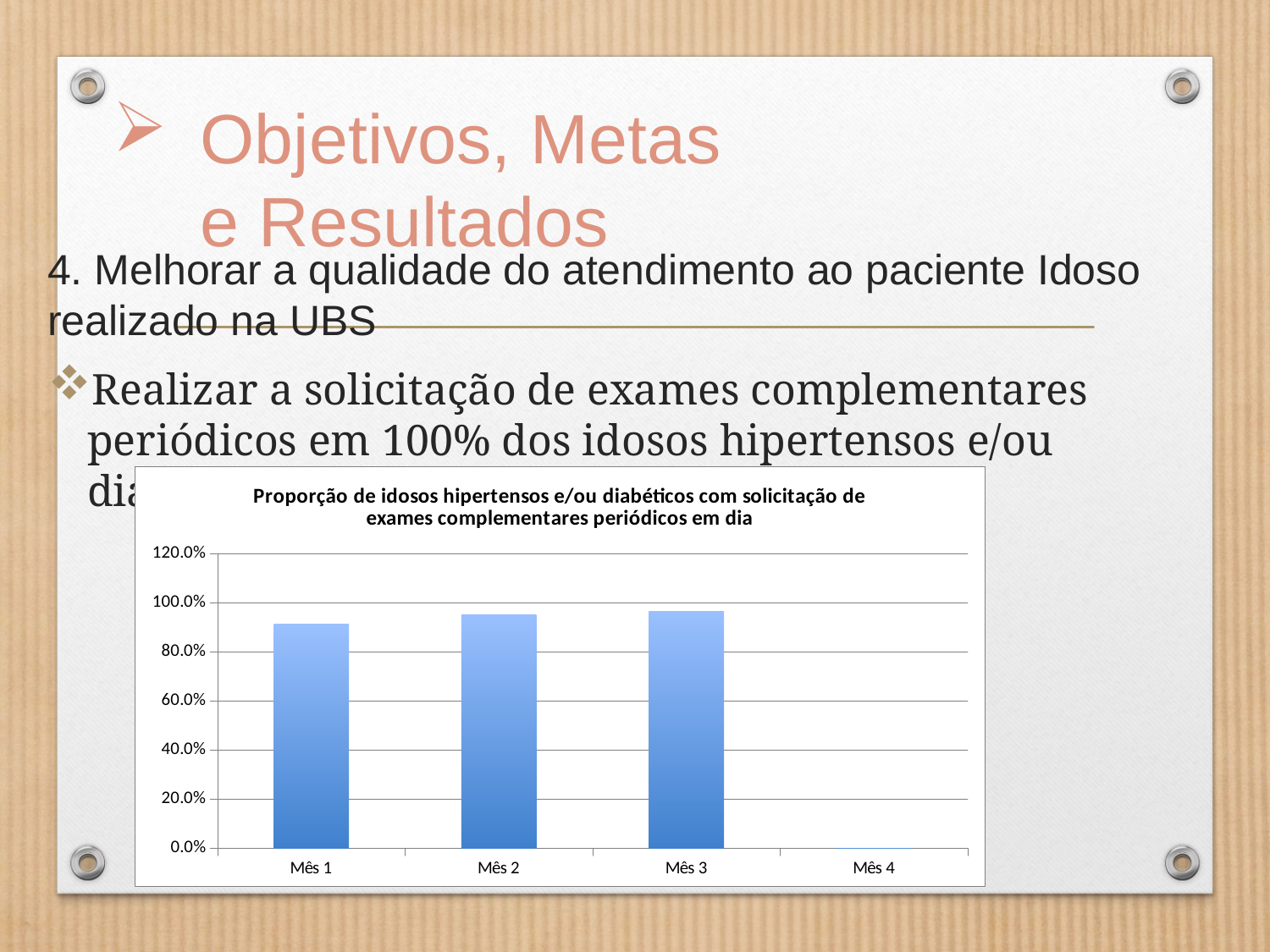
What is the title of the chart? Proporção de idosos hipertensos e/ou diabéticos com solicitação de exames complementares periódicos em dia Is the value for Mês 1 greater or less than 100.0%? less Is the value for Mês 2 greater or less than 80.0%? greater Which month has the lowest value in the chart? Mês 4 Do the values rise or fall from Mês 1 to Mês 3? rise Which is larger, the value for Mês 1 or the value for Mês 3? Mês 3 How many months (categories) are shown on the x axis of the chart? 4 Is the value for Mês 3 greater or less than 100.0%? less What is the highest value shown on the y axis of the chart? 120.0% What kind of chart is shown on the slide? Bar chart